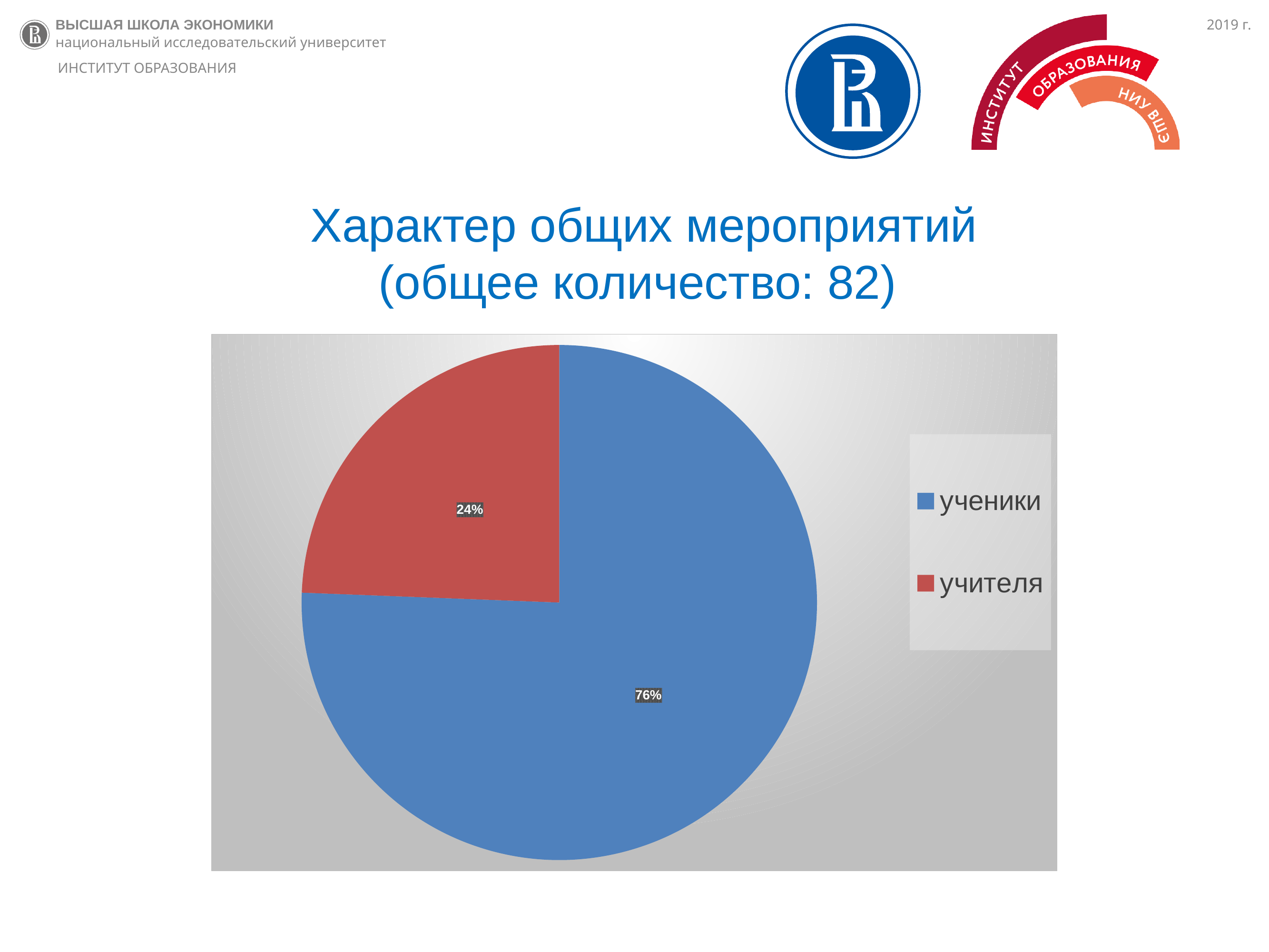
What share of the pie does the "ученики" slice represent? 76% What kind of chart is shown on the slide? pie chart What colour is the "учителя" slice? red What total number of events is stated in the slide title? 82 Which category has the largest slice of the pie? ученики How many slices does the pie chart have? 2 Which category has the smallest slice of the pie? учителя What is the difference in percentage points between the "ученики" and "учителя" slices? 52 Which slice is larger, "ученики" or "учителя"? ученики How many entries does the legend list? 2 What share of the pie does the "учителя" slice represent? 24%